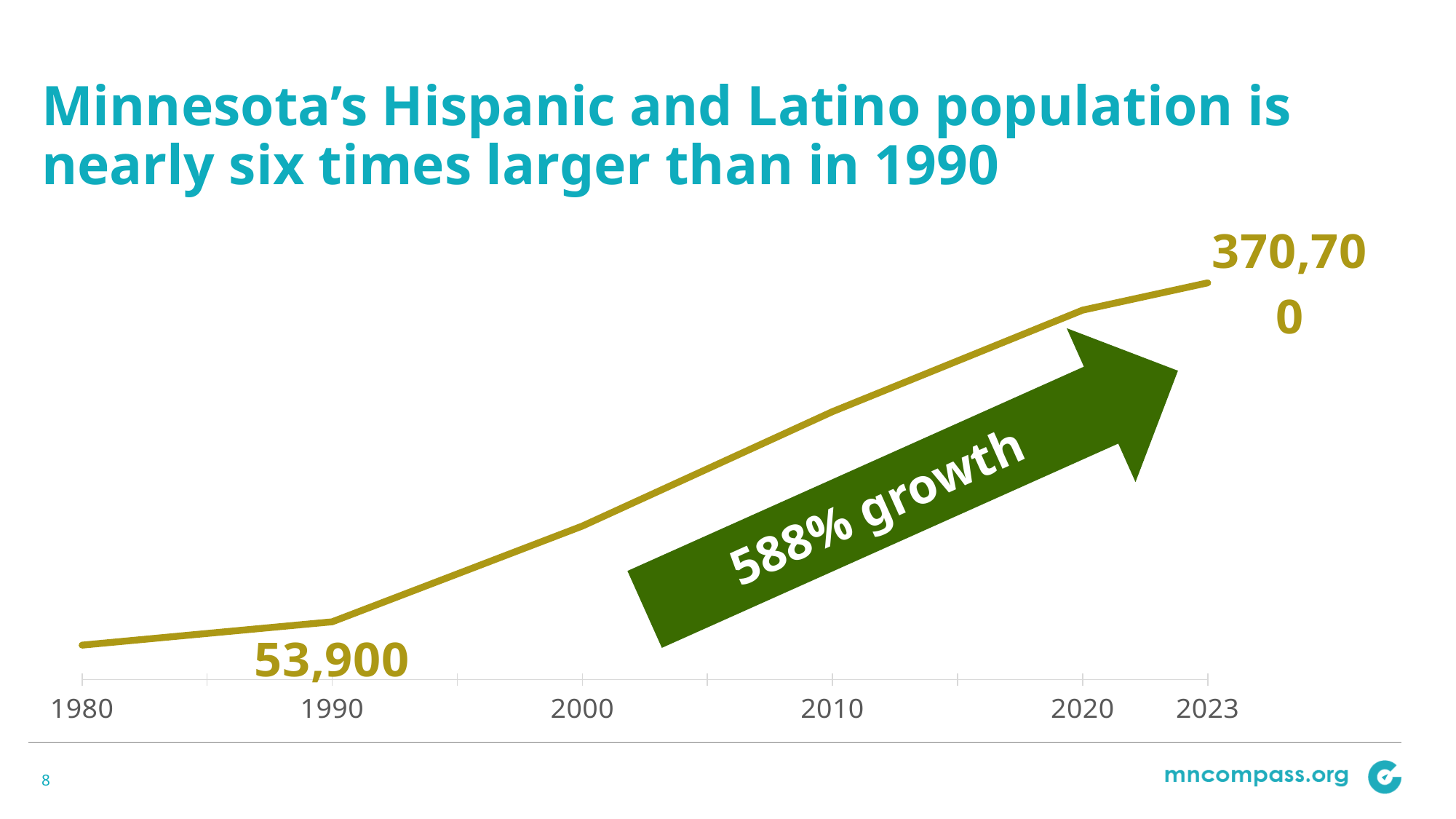
Do the values rise or fall from 1980 to 2023? Rise What growth percentage is written on the green arrow? 588% growth How many years are labelled on the x axis? 6 What is the value shown for 1990? 53,900 What kind of chart is shown on the slide? Line chart Which is larger, the value for 1990 or the value for 2023? 2023 What is the value shown for 2023? 370,700 What is the difference between the 2023 value and the 1990 value? 316,800 What is the first year labelled on the x axis? 1980 Which year has the highest value on the chart? 2023